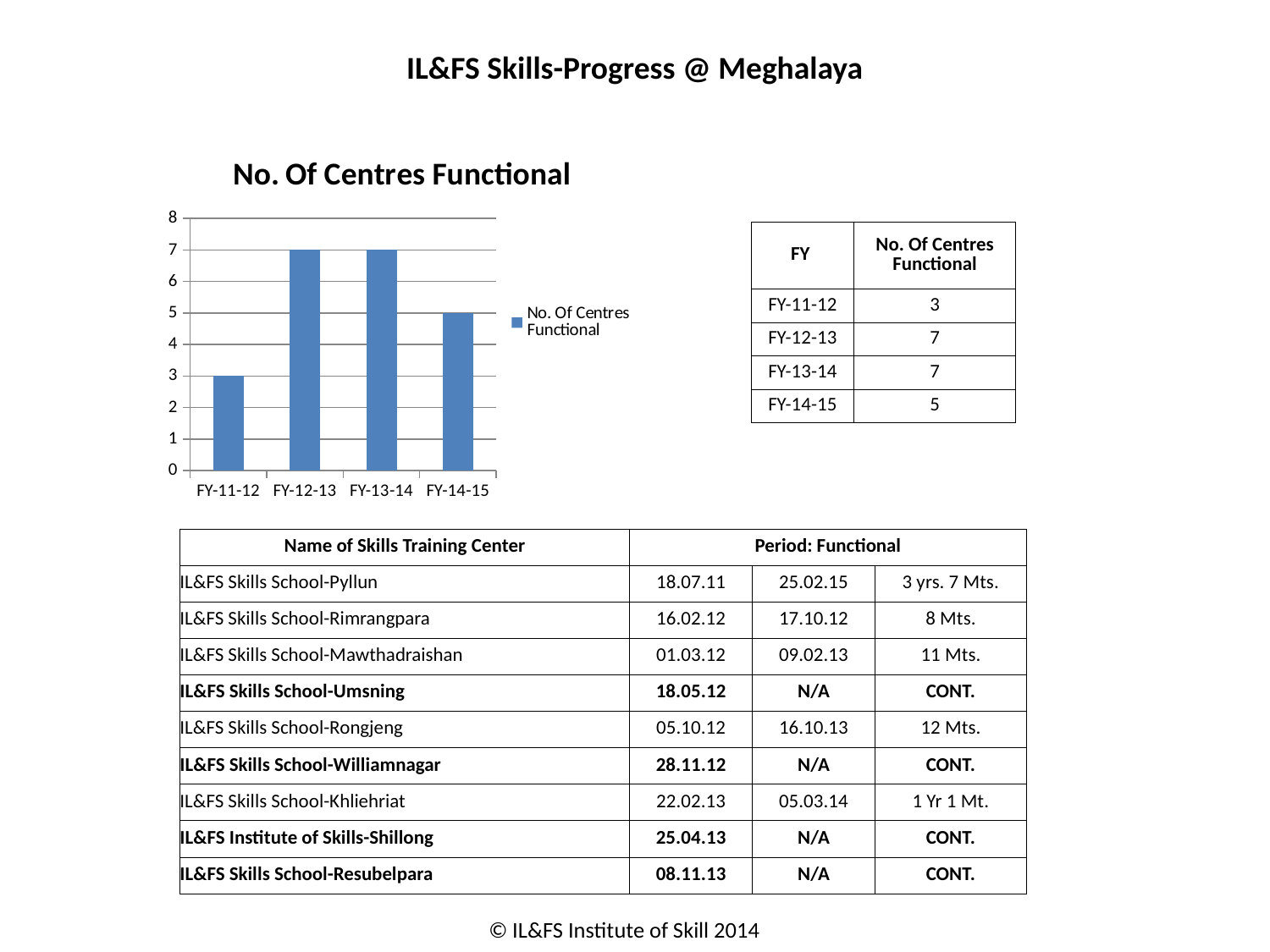
Is the value for FY-12-13 greater or less than 6? greater Does the number of centres functional rise or fall from FY-13-14 to FY-14-15? Fall Which has more centres functional, FY-11-12 or FY-14-15? FY-14-15 What is the title of the chart? No. Of Centres Functional What is the number of centres functional for FY-11-12? 3 How many categories are shown on the x axis of the chart? 4 Which fiscal year has the lowest number of centres functional? FY-11-12 What is the number of centres functional for FY-12-13? 7 What is the number of centres functional for FY-14-15? 5 How many series does the chart legend list? 1 What type of chart is shown on the slide? Bar chart What is the difference between the number of centres functional in FY-13-14 and FY-14-15? 2